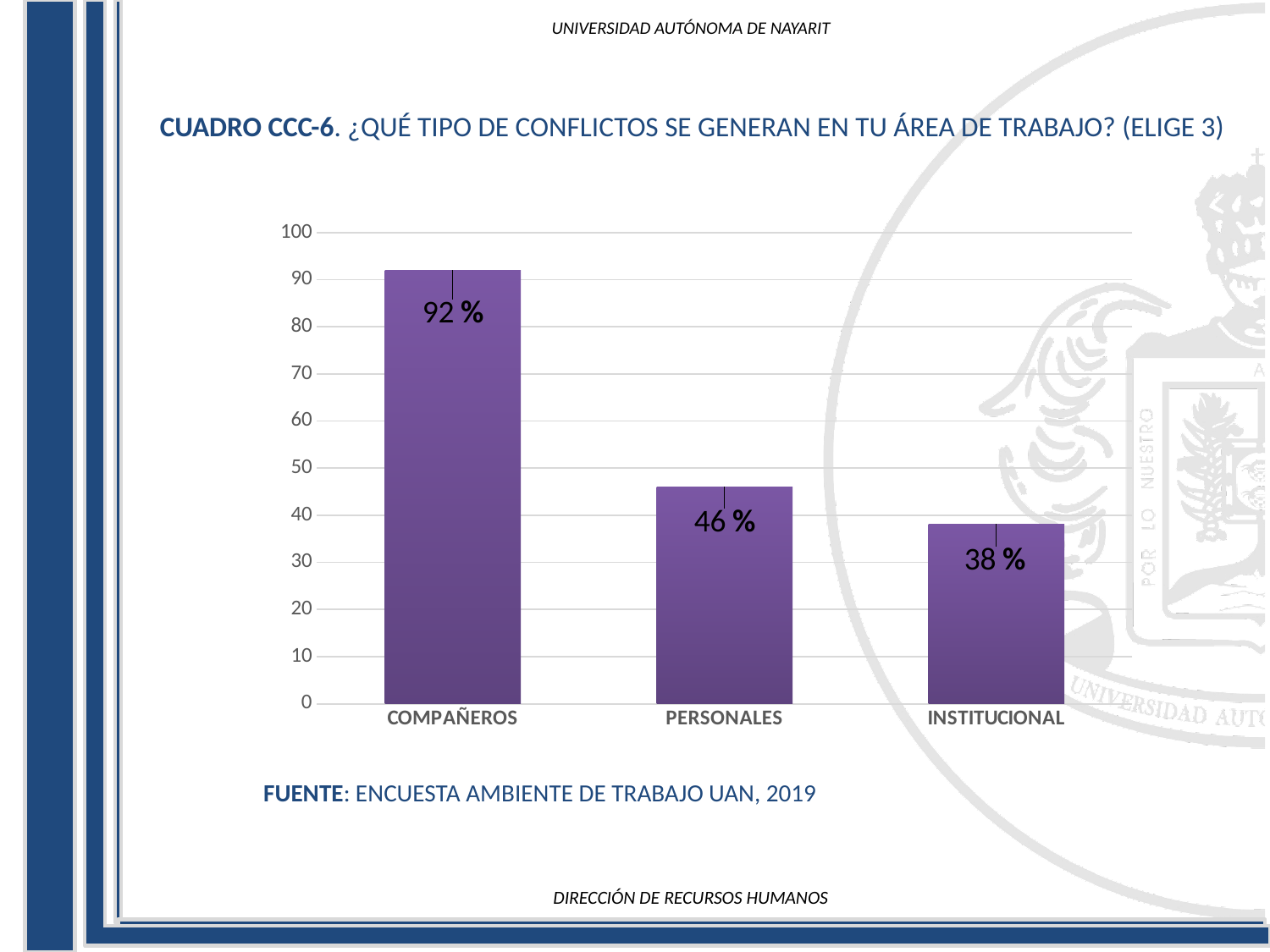
Which is larger, the value for PERSONALES or the value for INSTITUCIONAL? PERSONALES What kind of chart is shown on the slide? bar chart What is the value for PERSONALES? 46 % Which category has the highest value? COMPAÑEROS What is the difference between the values for PERSONALES and INSTITUCIONAL? 8 % What is the value for COMPAÑEROS? 92 % Which category has the lowest value? INSTITUCIONAL What is the value for INSTITUCIONAL? 38 % What source is cited below the chart? ENCUESTA AMBIENTE DE TRABAJO UAN, 2019 How many categories are shown in the chart? 3 Is the value for COMPAÑEROS greater or less than 80? greater What is the difference between the values for COMPAÑEROS and PERSONALES? 46 %